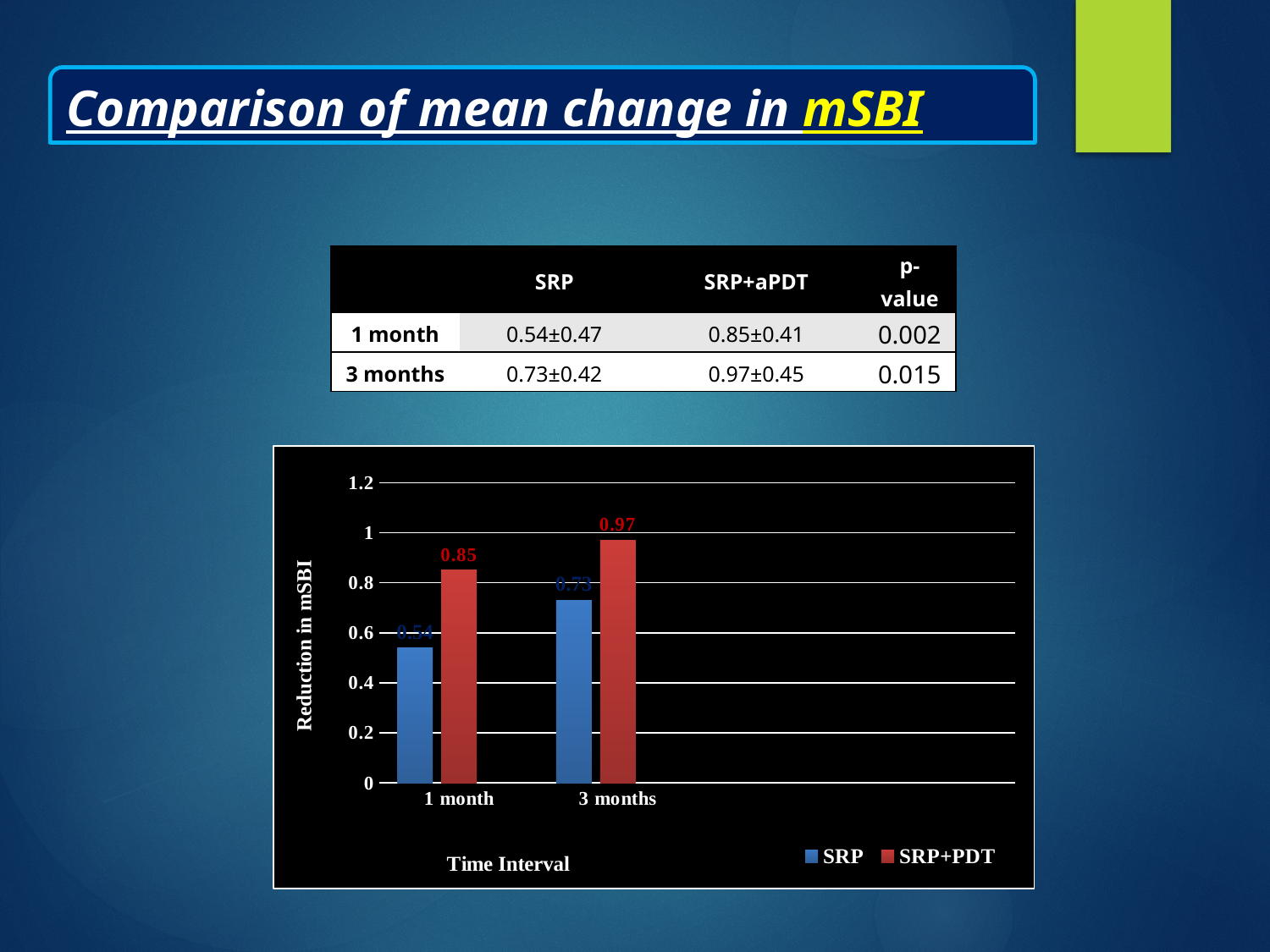
How many time intervals are shown on the x axis? 2 What is the value for SRP at 3 months? 0.73 Which bar has the lowest value in the chart? SRP at 1 month What is the value for SRP+PDT at 3 months? 0.97 Which is larger, SRP at 3 months or SRP+PDT at 1 month? SRP+PDT at 1 month How many series does the legend list? 2 What kind of chart is shown? Bar chart What is the value for SRP at 1 month? 0.54 What is the difference between SRP+PDT and SRP at 1 month? 0.31 What is the difference between SRP+PDT and SRP at 3 months? 0.24 Which series has the highest value at 3 months? SRP+PDT What is the value for SRP+PDT at 1 month? 0.85